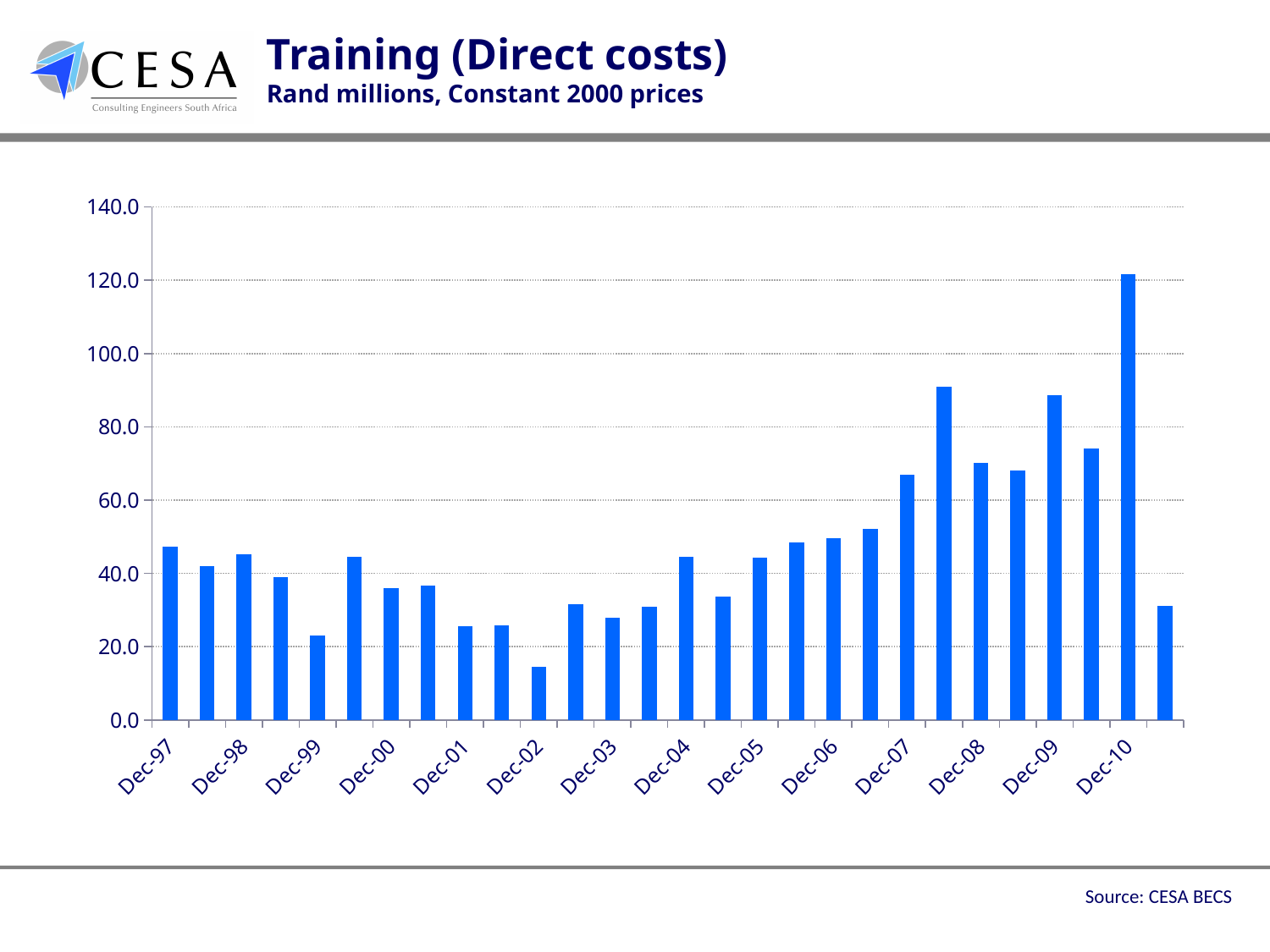
How many period labels are shown on the x axis? 14 What unit and price basis does the subtitle give for the chart values? Rand millions, Constant 2000 prices Is the value for Dec-10 greater or less than 100? greater Which is larger, the value for Dec-09 or the value for Dec-08? Dec-09 Is the value for Dec-08 greater or less than 60? greater What kind of chart is shown on the slide? bar chart Is the value for Dec-09 greater or less than 80? greater Which labelled period has the lowest value? Dec-02 Which is larger, the value for Dec-97 or the value for Dec-10? Dec-10 Which labelled period has the highest value? Dec-10